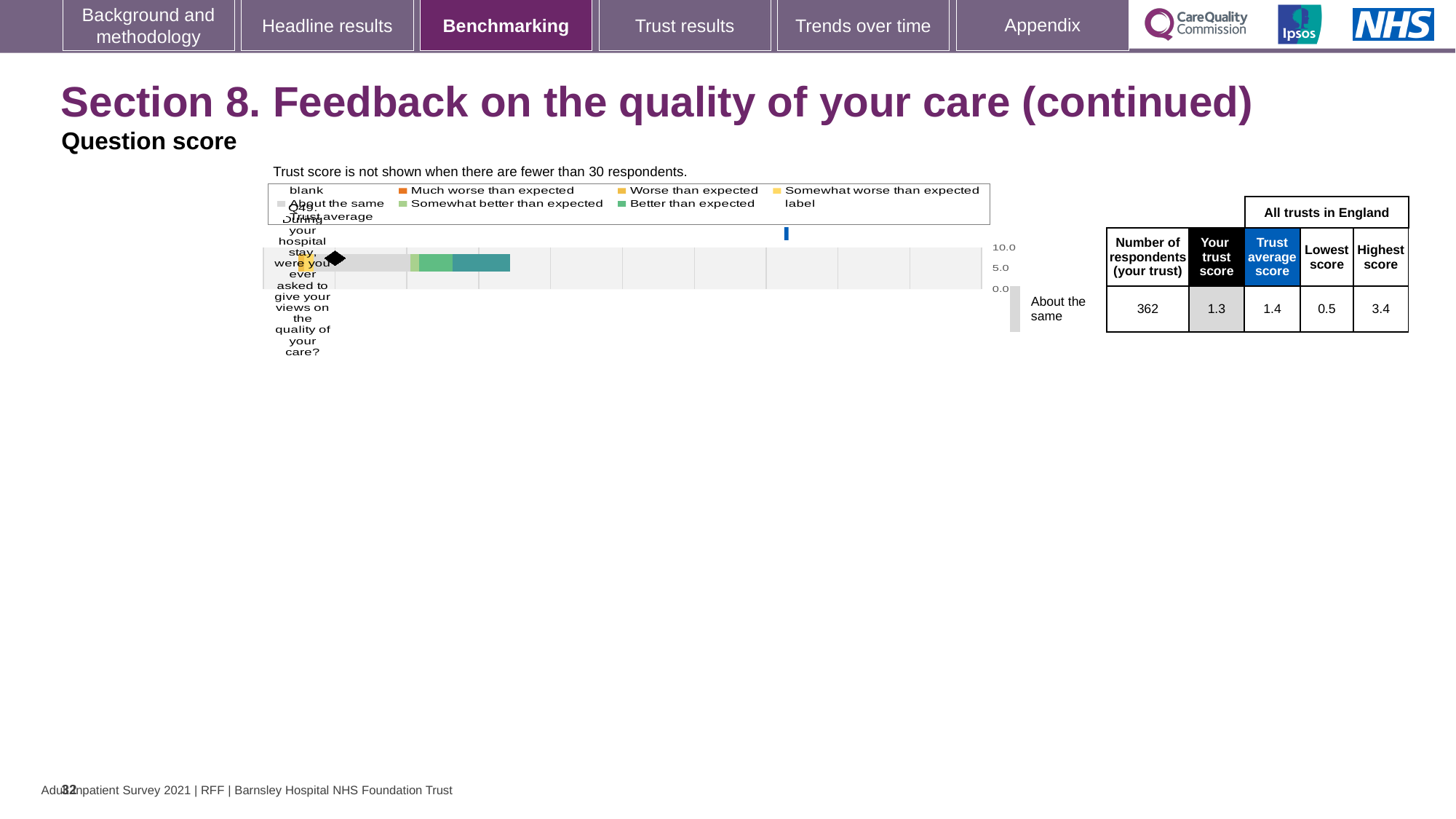
How many questions (categories) are plotted in the benchmarking chart? 1 Which is larger for Q49, the trust score or the trust average score? trust average score What is the trust score for Q49 shown in the table beside the chart? 1.3 What kind of chart is used to show the Q49 benchmarking result? bar chart What is the highest score among all trusts in England for Q49? 3.4 How many entries does the chart legend list? 9 How many respondents from the trust answered Q49? 362 What is the trust average score for Q49? 1.4 Which benchmark category is the trust's Q49 result placed in, as labelled next to the chart? About the same What is the difference between the highest and lowest scores for Q49 across all trusts in England? 2.9 What is the lowest score among all trusts in England for Q49? 0.5 Which legend entry is shown in orange? Much worse than expected